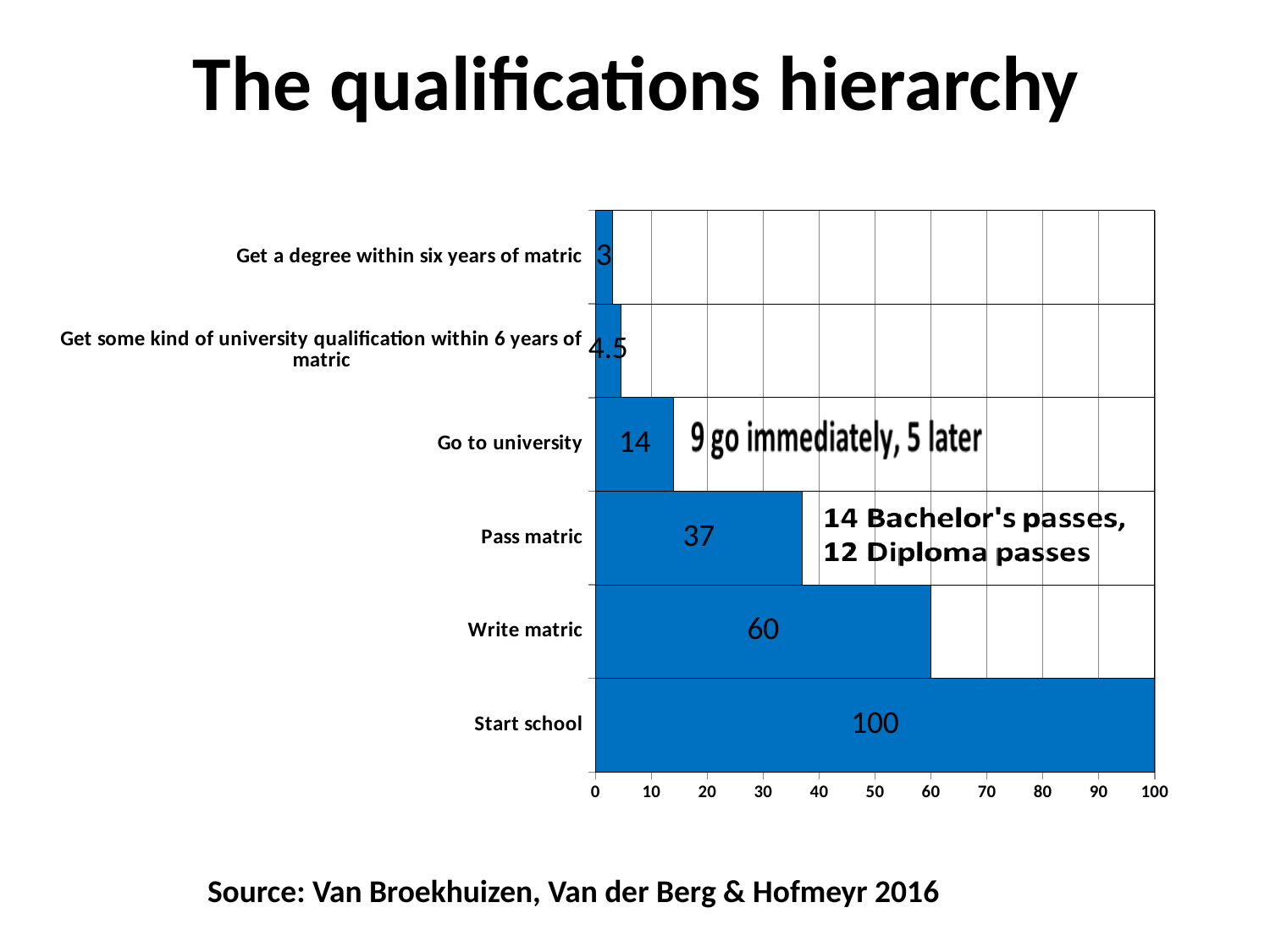
What is the value for Start school? 100 How many categories are shown on the chart? 6 What is the difference between the values for Write matric and Pass matric? 23 What is the value for Get a degree within six years of matric? 3 Which category has the highest value? Start school What is the value for Pass matric? 37 Which category has the lowest value? Get a degree within six years of matric What is the value for Go to university? 14 What is the value for Write matric? 60 Which is larger, the value for Go to university or the value for Pass matric? Pass matric What is the title of the slide? The qualifications hierarchy What kind of chart is shown on the slide? Bar chart